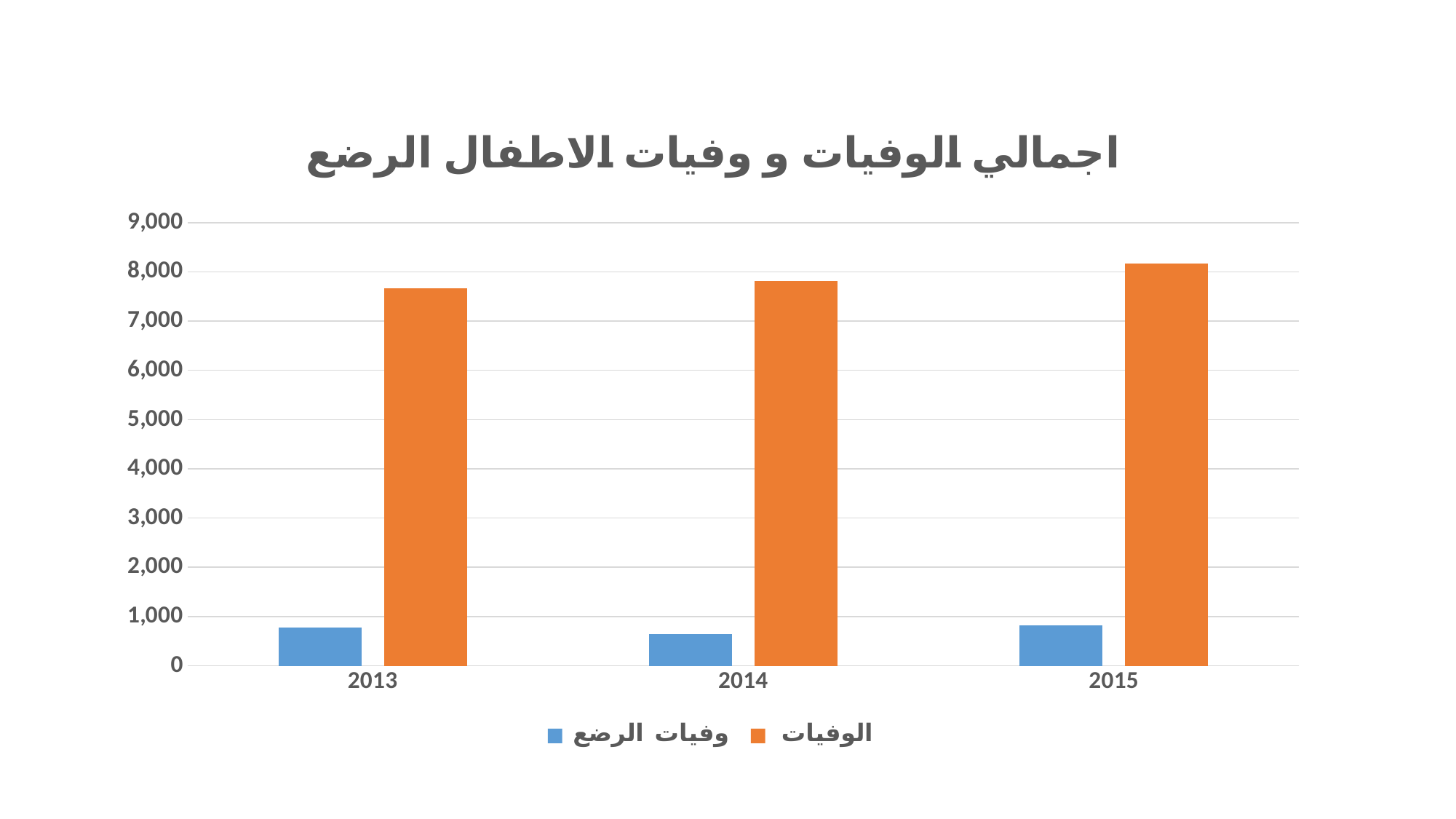
Is the value for الوفيات in 2013 greater or less than 8,000? less Do the values for الوفيات rise or fall from 2013 to 2015? rise Which year has the lowest value for وفيات الرضع? 2014 How many years are shown on the x axis? 3 Which year has the highest value for الوفيات? 2015 What kind of chart is shown on the slide? bar chart Is the value for وفيات الرضع in 2014 greater or less than 1,000? less Is the value for الوفيات in 2015 greater or less than 8,000? greater How many series does the legend list? 2 Which colour represents وفيات الرضع in the chart? blue What is the title of the chart? اجمالي الوفيات و وفيات الاطفال الرضع In 2014, which series has the larger value, الوفيات or وفيات الرضع? الوفيات